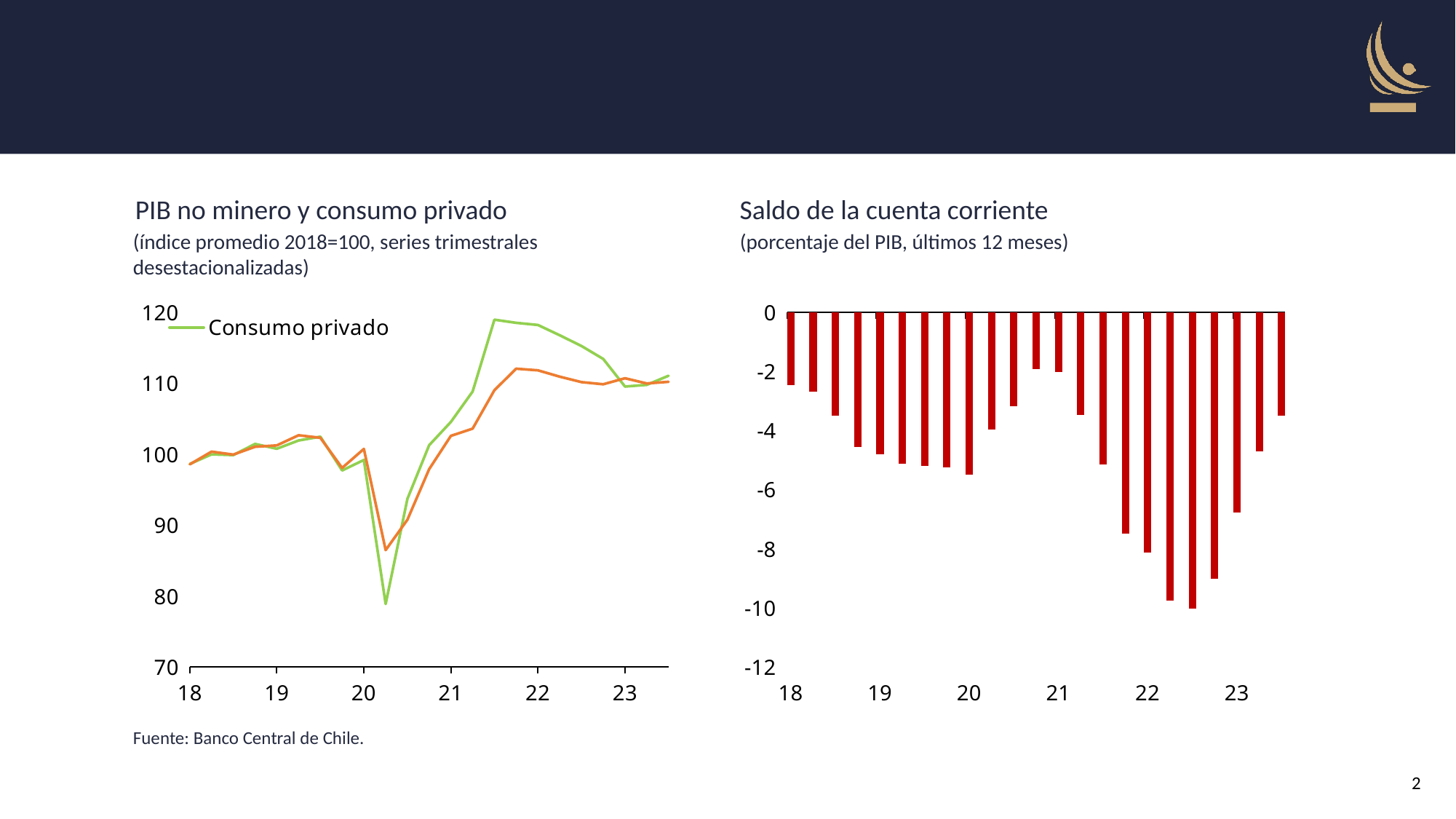
In the 'Saldo de la cuenta corriente' chart, under which x-axis year label does the lowest bar appear? 22 What kind of chart is the 'Saldo de la cuenta corriente' chart on the right? Bar chart In the 'Saldo de la cuenta corriente' chart, is the lowest bar greater or less than -8? less In the 'Saldo de la cuenta corriente' chart, is the first bar (at 18) greater or less than -4? greater In the 'Saldo de la cuenta corriente' chart, do the bar values rise or fall from 21 to the lowest bar in 22? Fall In the 'PIB no minero y consumo privado' chart, is the peak value of the Consumo privado line (around 21-22) greater or less than 110? greater What kind of chart is the 'PIB no minero y consumo privado' chart on the left? Line chart In the 'PIB no minero y consumo privado' chart, what series name does the legend show? Consumo privado In the 'PIB no minero y consumo privado' chart, at the trough in 2020, which line is lower: the green Consumo privado line or the orange line? Consumo privado (green) In the 'Saldo de la cuenta corriente' chart, what colour are the bars? Red In the 'PIB no minero y consumo privado' chart, does the Consumo privado line rise or fall between the 2020 trough and 21.5? Rise